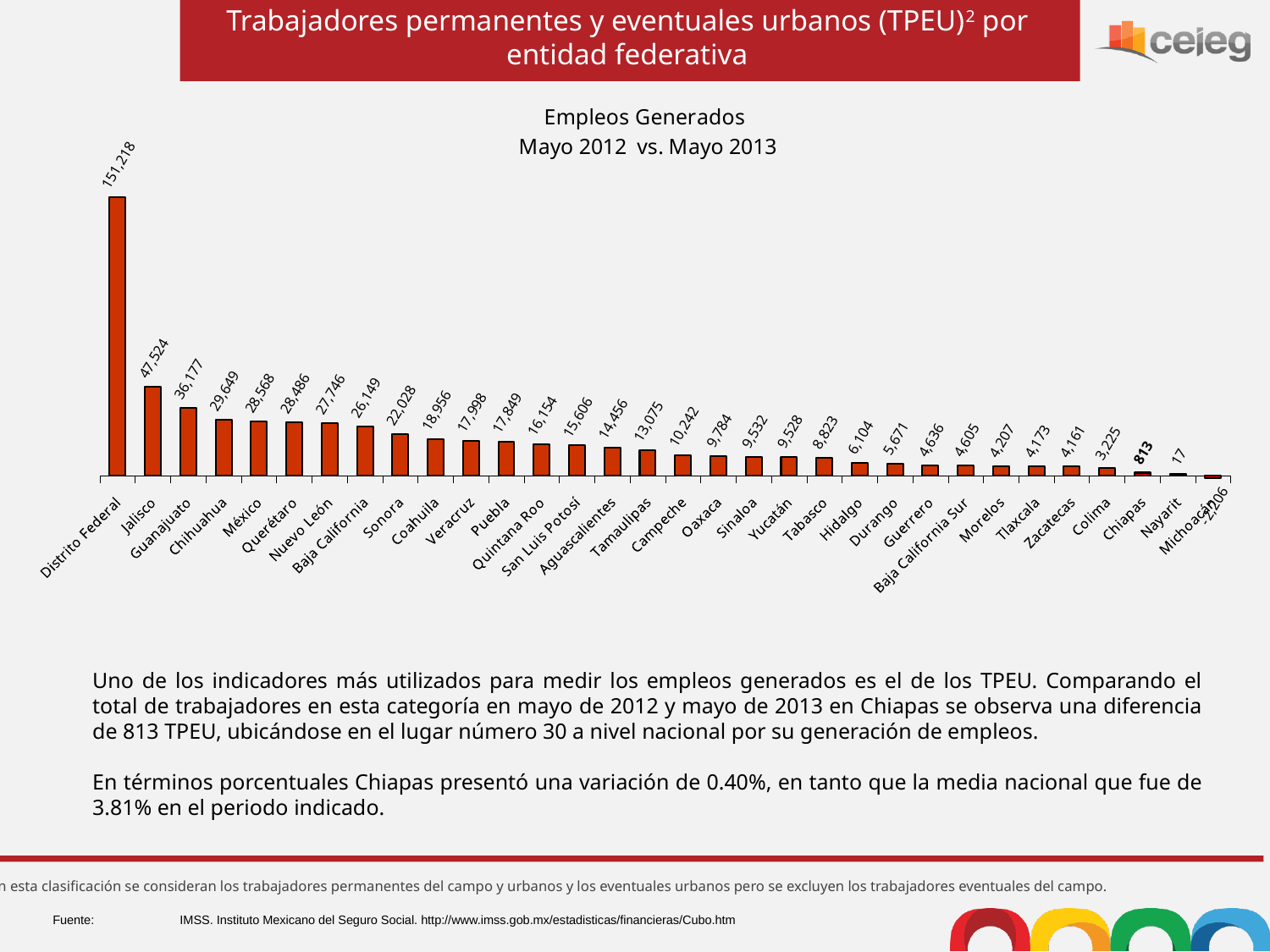
How many entities are shown on the chart? 32 What is the value for Distrito Federal? 151,218 Which entity has the highest value? Distrito Federal What is the difference between the values for Jalisco and Guanajuato? 11,347 What is the value for Nayarit? 17 What is the value for Chiapas? 813 What is the value for Jalisco? 47,524 What is the title of the chart? Empleos Generados Mayo 2012 vs. Mayo 2013 Which entity has the lowest value? Michoacán Which is larger, the value for Sonora or the value for Coahuila? Sonora Do the values rise or fall from left to right along the x axis? Fall What kind of chart is this? Bar chart